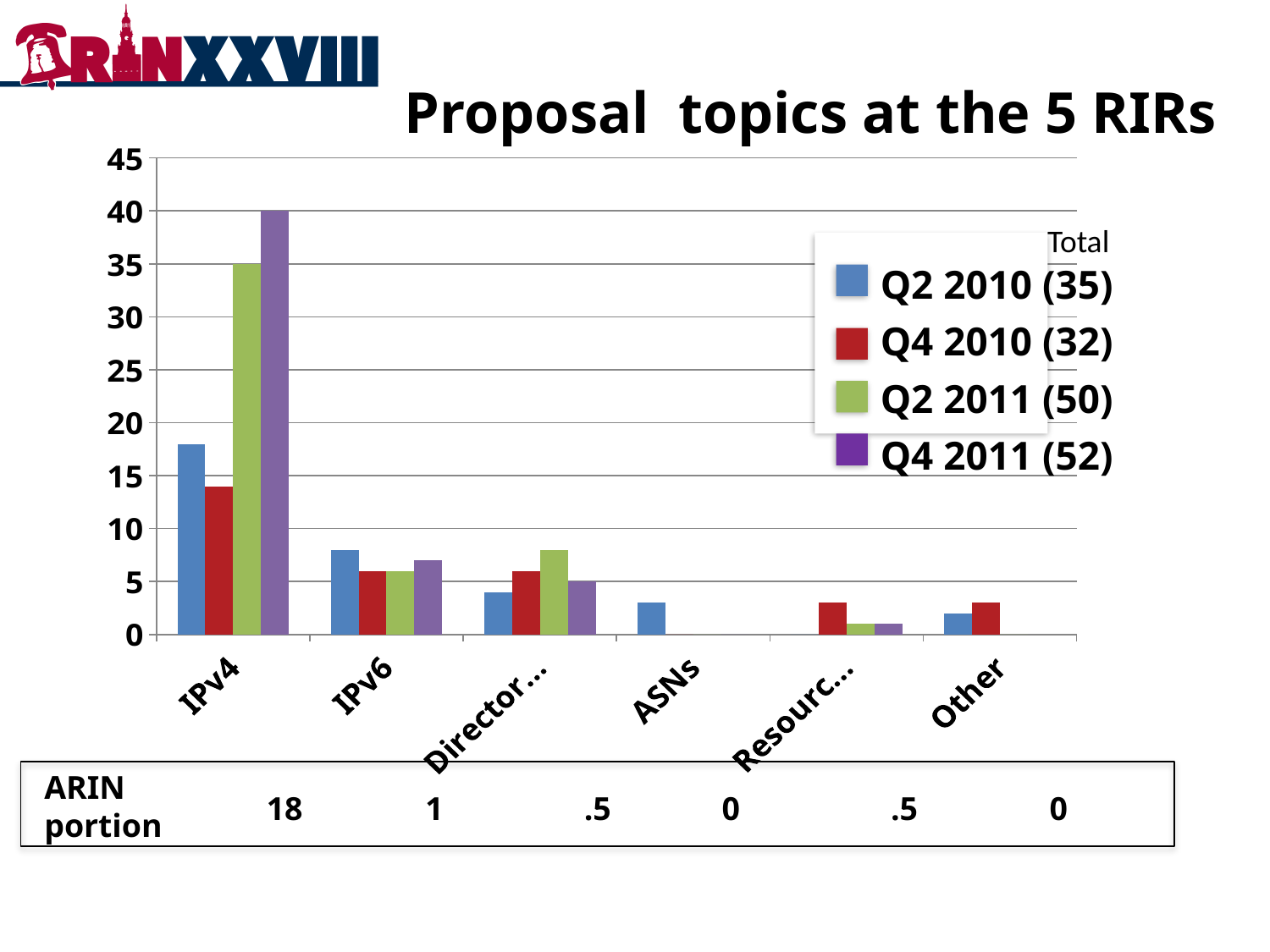
What is the Q2 2011 value for IPv4? 35 Is the Q2 2010 value for IPv4 greater or less than 15? greater What is the Q4 2011 value for IPv4? 40 What is the difference between the Q4 2011 and Q2 2011 values for IPv4? 5 Is the Q2 2010 value for IPv6 greater or less than 10? less Do the Q2 2010 values rise or fall from IPv4 to ASNs? fall What total does the legend give for Q2 2011? 50 What kind of chart is shown on the slide? bar chart How many categories are shown along the x axis? 6 Which category has the highest Q4 2011 value? IPv4 For the Director category, which is larger: the Q2 2011 value or the Q2 2010 value? Q2 2011 How many series does the legend list? 4